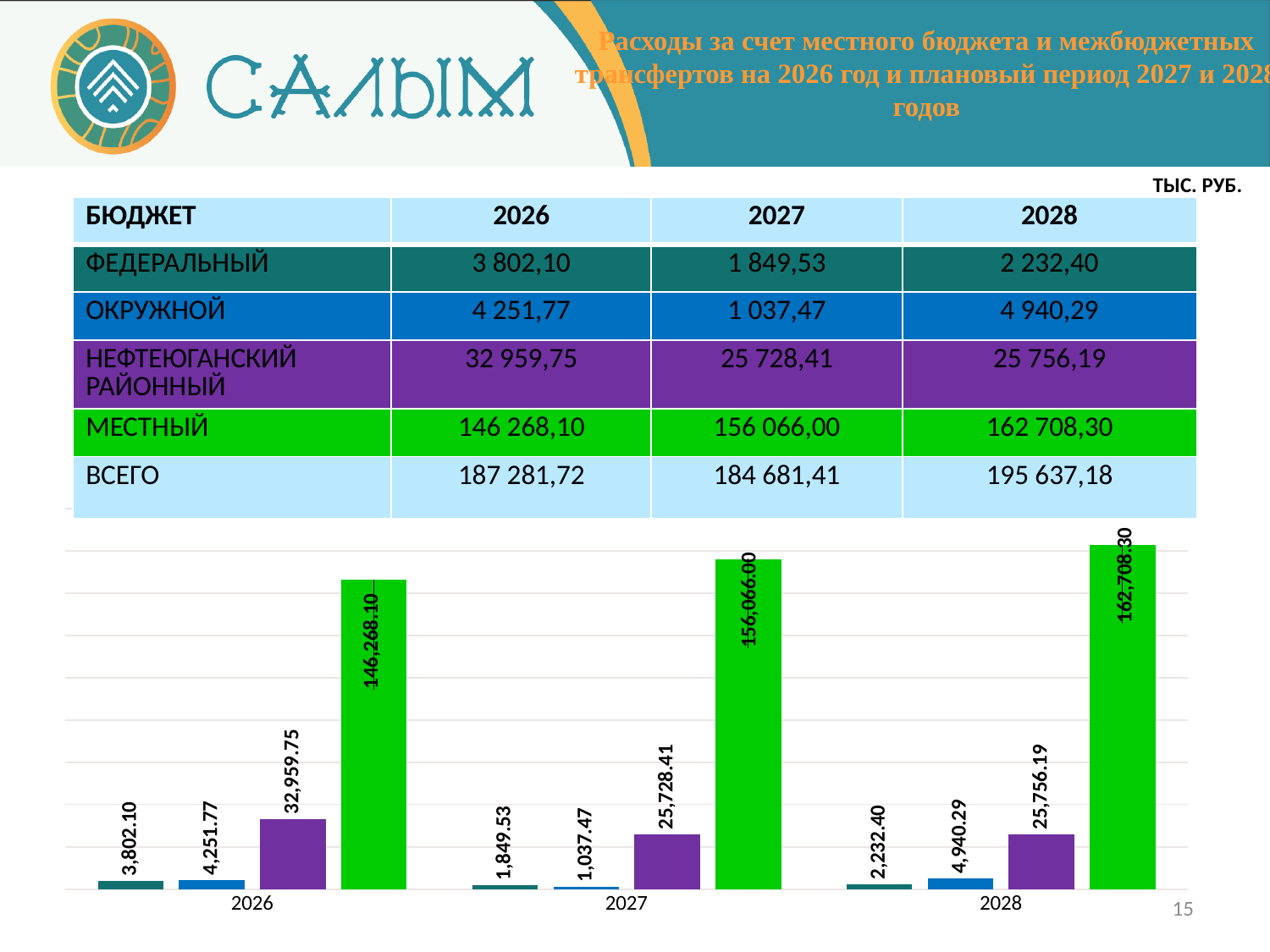
What is the value of the tallest (green) bar for 2026 in the chart? 146,268.10 What is the value of the purple bar for 2028 in the chart? 25,756.19 What is the value of the green bar for 2027 in the chart? 156,066.00 Which year has the highest green bar in the chart? 2028 What type of chart is shown on the slide? bar chart Which is larger in the chart: the blue bar for 2026 or the blue bar for 2028? the blue bar for 2028 How many bars are plotted for each year in the chart? 4 What is the difference between the purple bar for 2026 and the purple bar for 2027 in the chart? 7,231.34 What is the difference between the green bar for 2028 and the green bar for 2026 in the chart? 16,440.20 What is the value of the smallest bar for 2027 in the chart? 1,037.47 Do the green bars rise or fall from 2026 to 2028 in the chart? rise How many year categories are shown on the x axis of the chart? 3